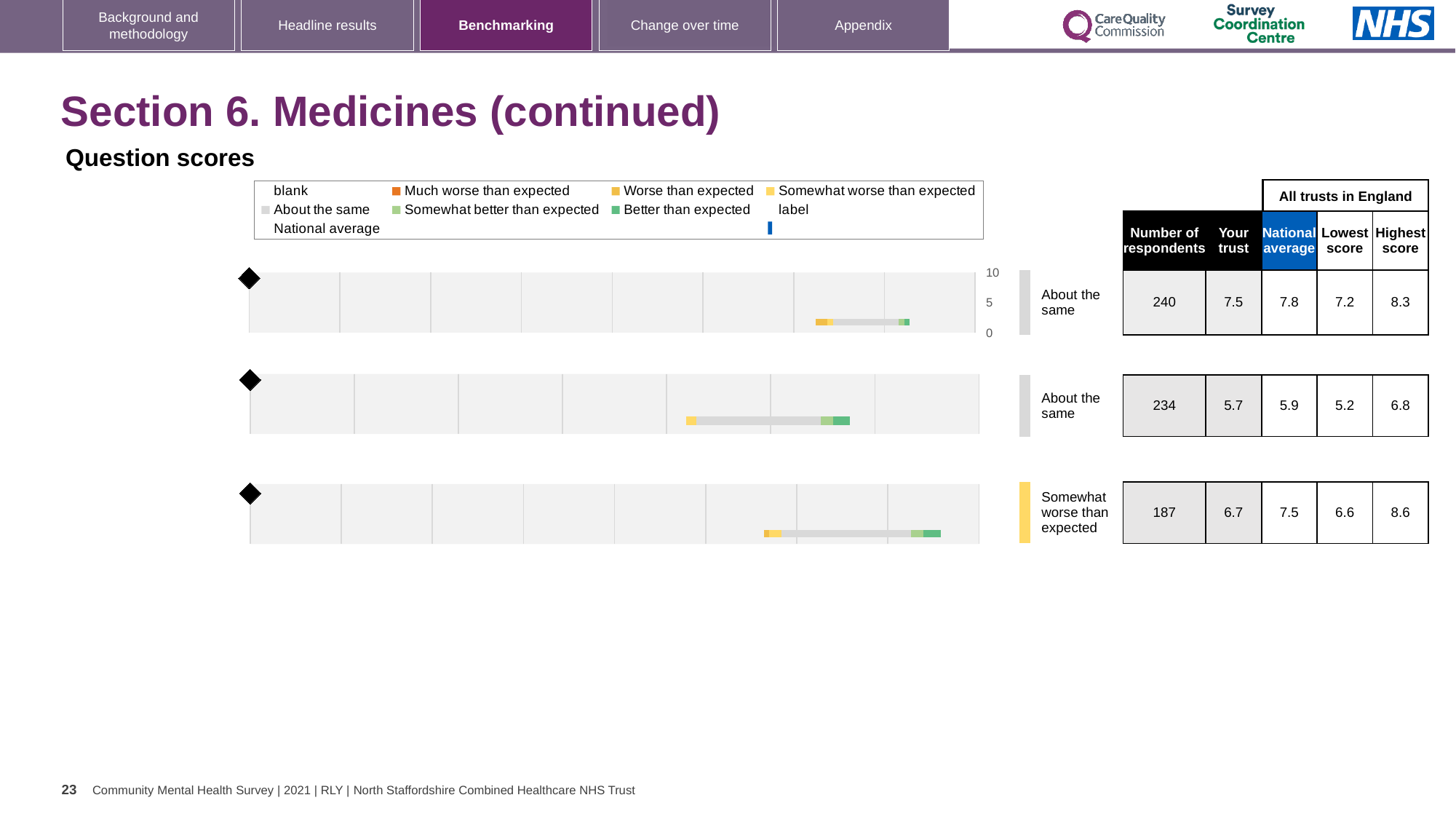
Which of the three charts has the lowest 'Your trust' score? the middle chart For the top chart, what is the difference between the highest score and the lowest score? 1.1 What kind of chart is used to show the question scores on this slide? bar chart For the bottom chart, what is the highest score among all trusts in England? 8.6 For the middle chart, how many respondents are listed? 234 For the bottom chart, what benchmark category is the trust's score given? Somewhat worse than expected For the bottom chart, how much higher is the national average than the 'Your trust' score? 0.8 For the top chart, what is the national average score? 7.8 For the middle chart, which is larger: the 'Your trust' score or the national average? national average How many question score charts are shown on the slide? 3 For the top chart, what is the 'Your trust' score shown in the table? 7.5